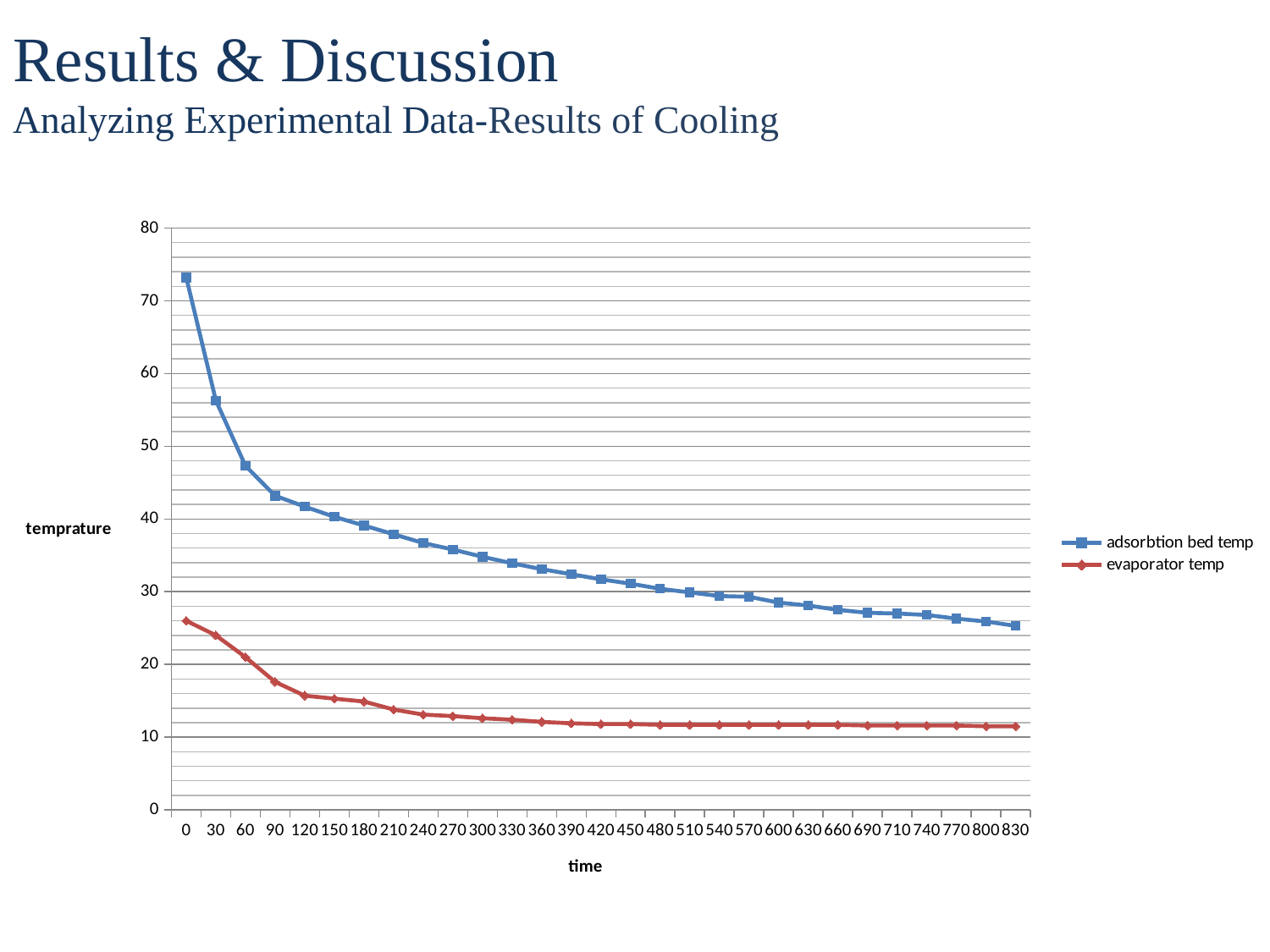
Is the adsorbtion bed temp at time 0 greater or less than 70? greater At which time is the adsorbtion bed temp highest? 0 What are the two series named in the legend? adsorbtion bed temp and evaporator temp How many time points are plotted along the x axis? 29 What is the label on the vertical axis? temprature How many series does the legend list? 2 Is the adsorbtion bed temp at time 830 greater or less than 30? less What kind of chart is shown on the slide? line chart Is the evaporator temp at time 0 greater or less than 30? less Does the evaporator temp rise or fall as time increases? fall Does the adsorbtion bed temp rise or fall as time increases? fall Which series has the larger value at time 0, adsorbtion bed temp or evaporator temp? adsorbtion bed temp